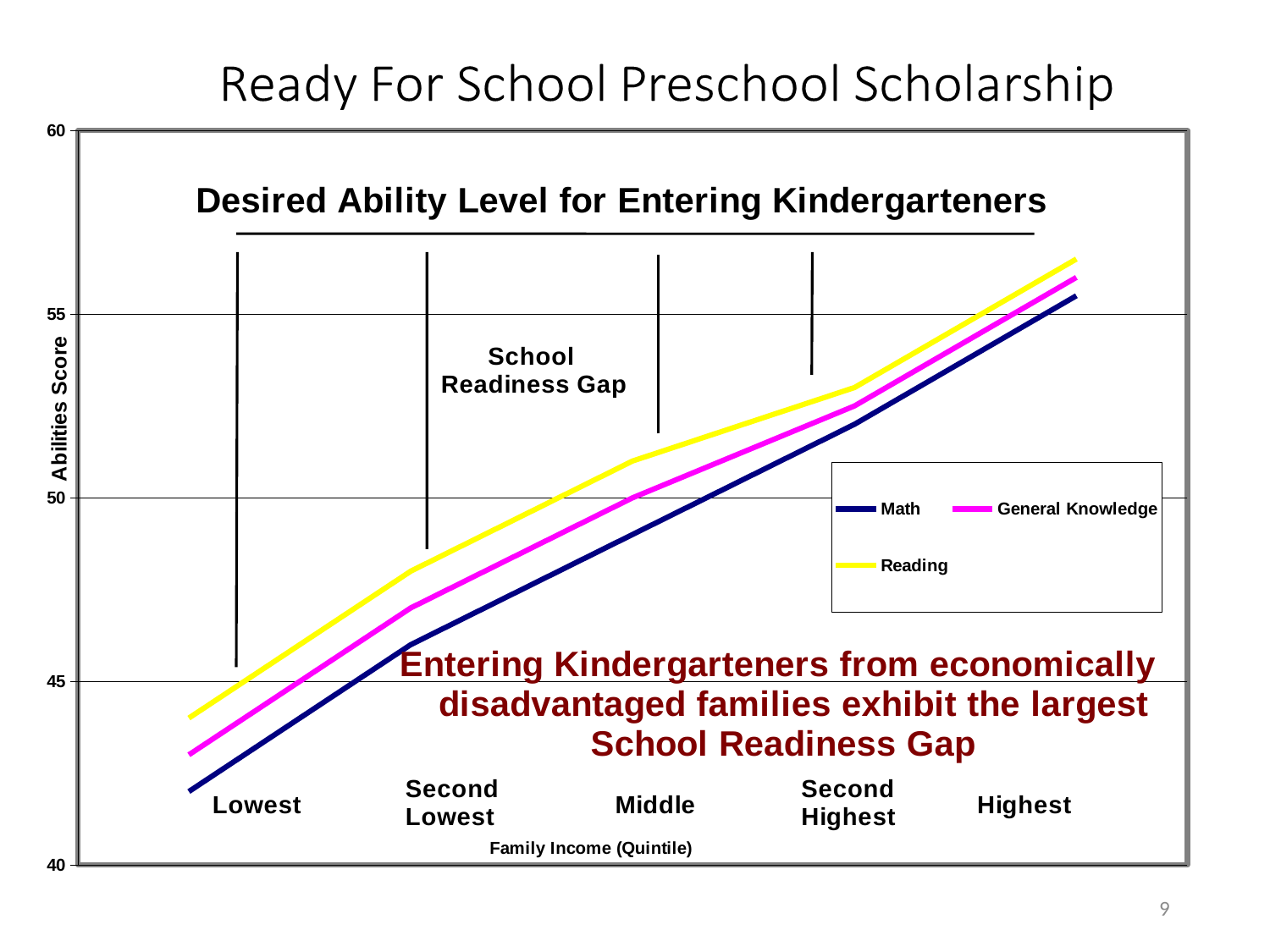
Is the General Knowledge score for the Second Lowest income quintile greater or less than 50? less Do the Math scores rise or fall as family income moves from Lowest to Highest? rise What kind of chart is shown on the slide? line chart For which family income quintile is the Reading score highest? Highest How many series does the legend list? 3 Is the Reading score for the Second Highest income quintile greater or less than 50? greater What is the title of the vertical axis? Abilities Score Which series has the lowest score for the Highest income quintile? Math How many family income quintile categories are shown on the x axis? 5 Is the Math score for the Lowest income quintile greater or less than 45? less Which series has the highest score for the Lowest income quintile? Reading Which is larger for the Middle income quintile, the Reading score or the Math score? Reading